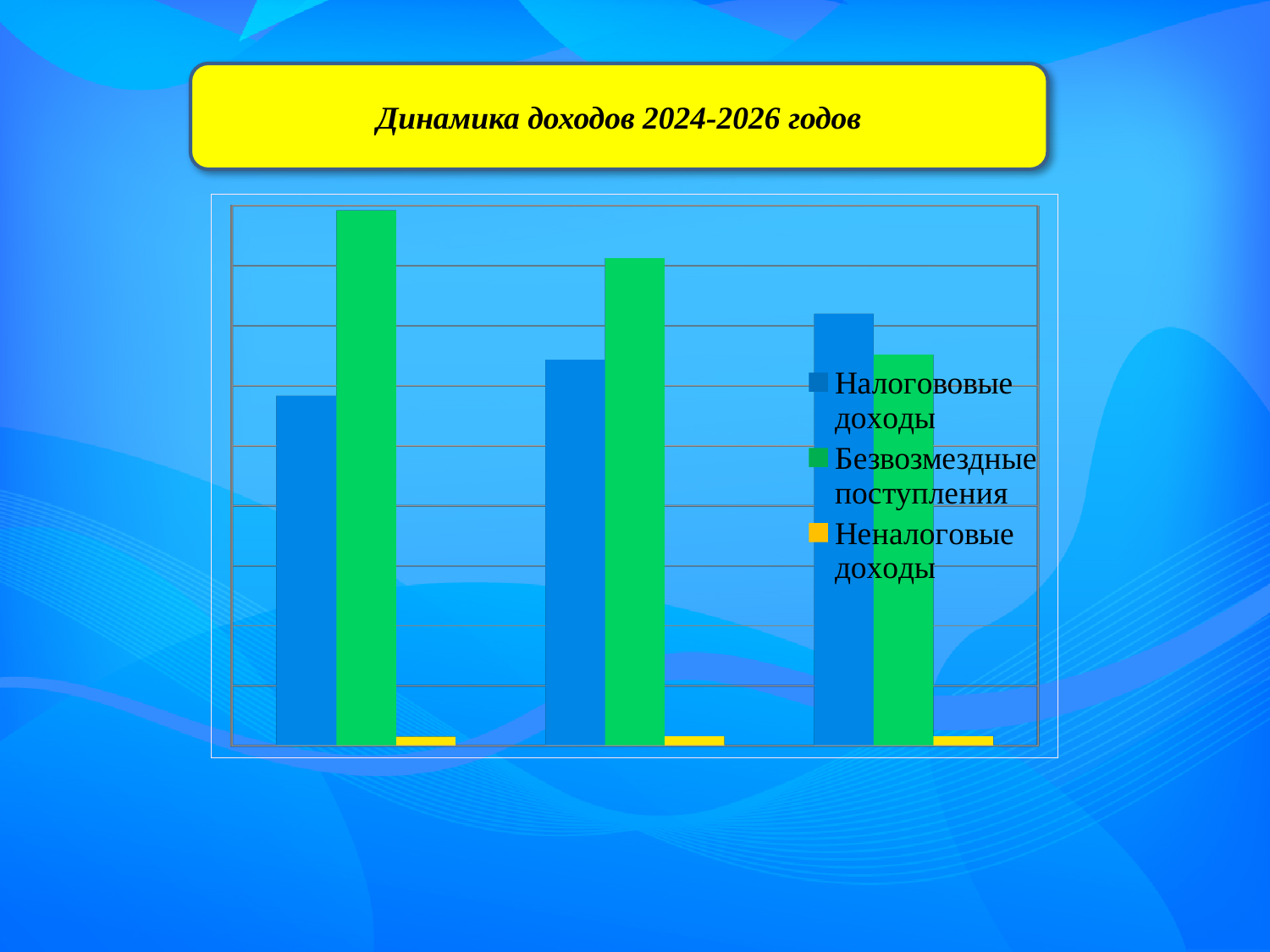
How many series does the legend list? 3 What kind of chart is shown on the slide? bar chart In the second (middle) group, which is larger: Налоговые доходы or Безвозмездные поступления? Безвозмездные поступления Do the bars for Налоговые доходы rise or fall from left to right across the groups? rise Which series is shown in green in the legend? Безвозмездные поступления Which series has the shortest bar in every group? Неналоговые доходы Do the bars for Безвозмездные поступления rise or fall from left to right across the groups? fall What is the title of the slide above the chart? Динамика доходов 2024-2026 годов How many groups of bars are plotted in the chart? 3 Which series has the tallest bar in the first (leftmost) group? Безвозмездные поступления In the third (rightmost) group, which is larger: Налоговые доходы or Безвозмездные поступления? Налоговые доходы Which series has the tallest bar in the third (rightmost) group? Налоговые доходы